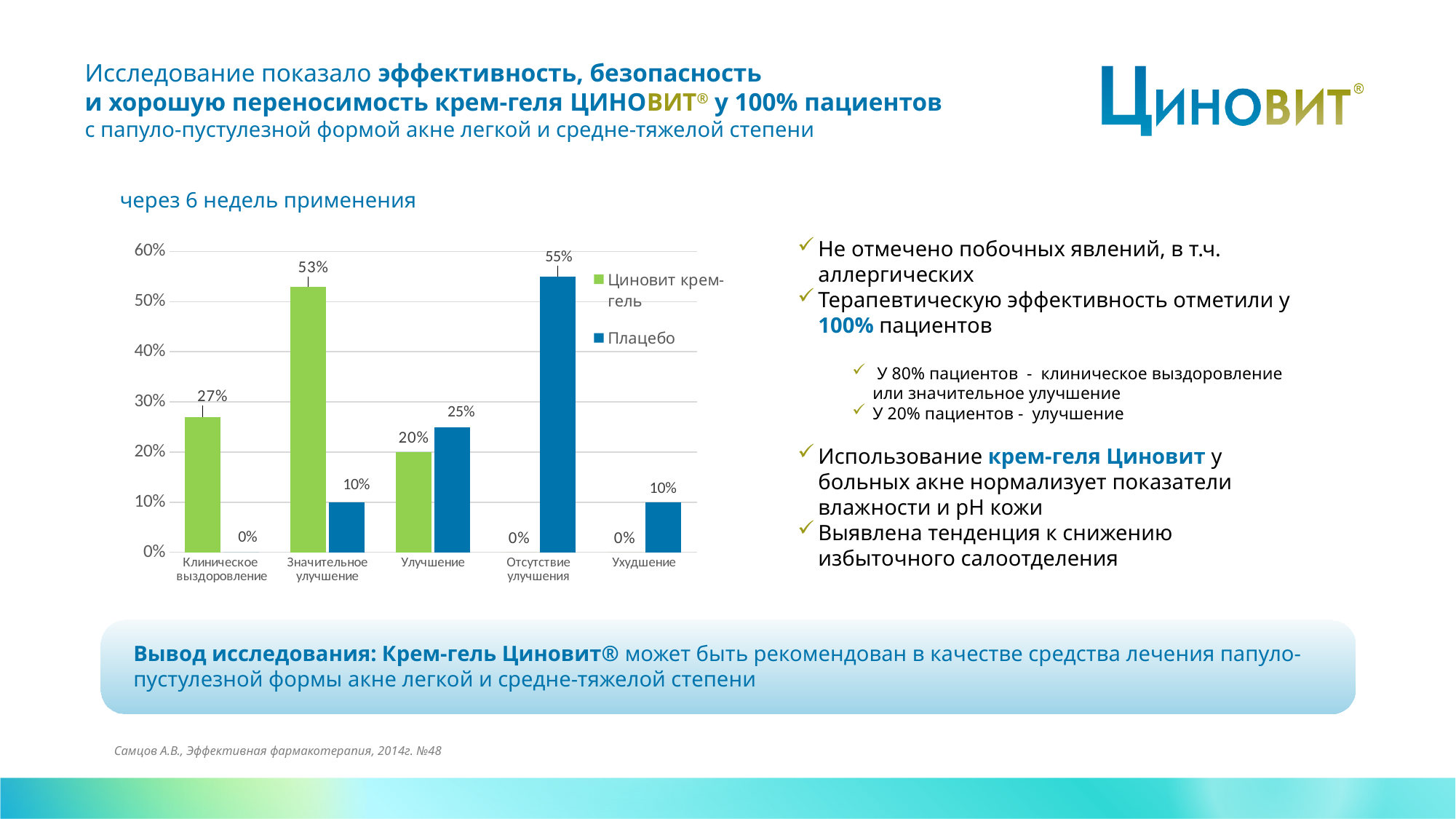
What is the value for Плацебо in the category Ухудшение? 10% What is the value for Циновит крем-гель in the category Клиническое выздоровление? 27% In which category does Плацебо have its highest value? Отсутствие улучшения In which category does Циновит крем-гель have its highest value? Значительное улучшение What is the value for Плацебо in the category Отсутствие улучшения? 55% What is the value for Циновит крем-гель in the category Значительное улучшение? 53% In the category Улучшение, which series has the larger value, Циновит крем-гель or Плацебо? Плацебо How many series does the chart legend list? 2 What is the difference between Циновит крем-гель and Плацебо in the category Значительное улучшение? 43% Which colour represents the Плацебо series in the chart? Blue What type of chart is shown on the slide? Bar chart How many categories are shown on the x axis of the chart? 5